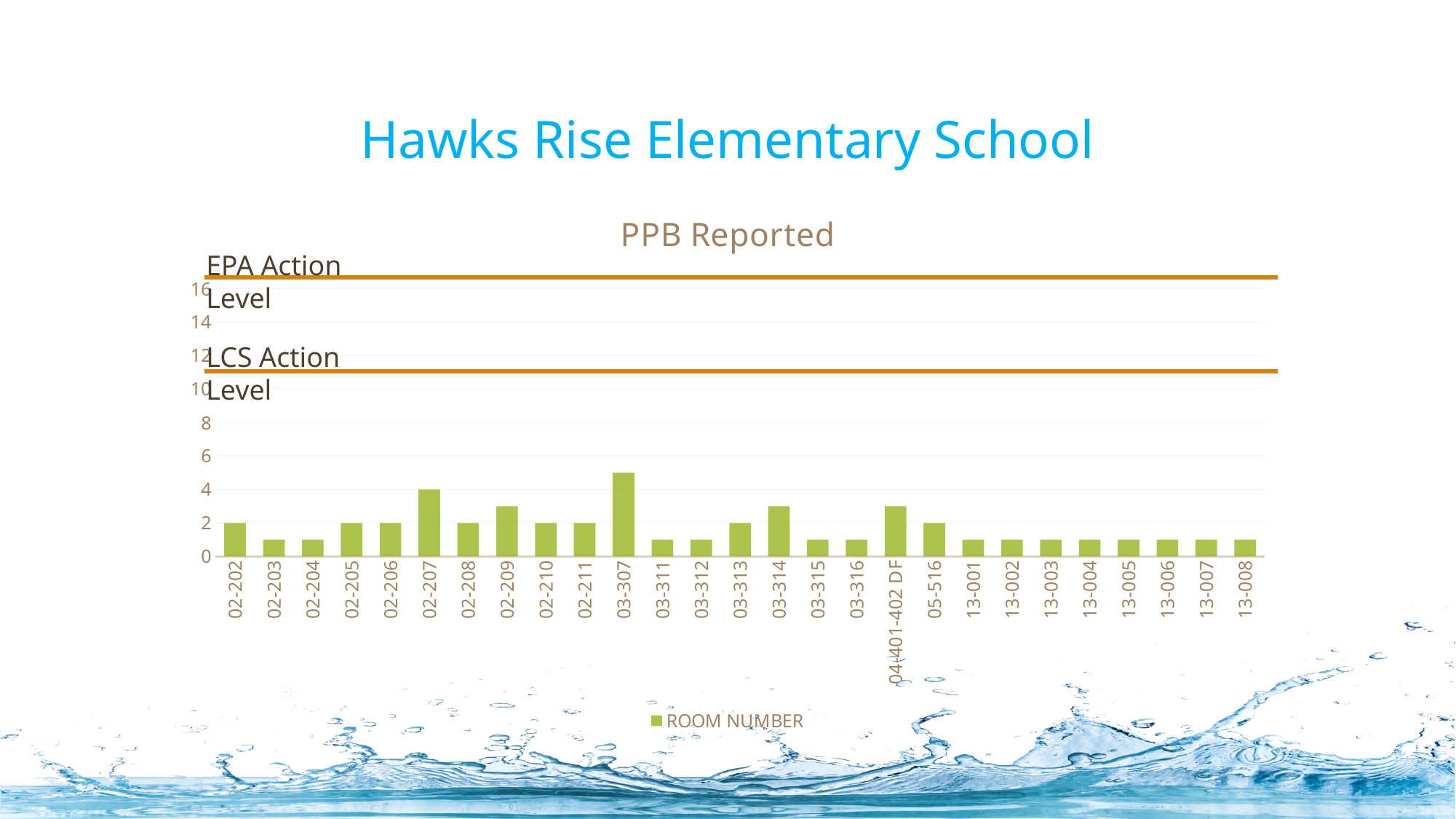
What is the legend entry for the plotted series? ROOM NUMBER How many series does the legend list? 1 Which room has the highest PPB reported value? 03-307 Is the value for room 03-307 greater or less than 4? greater What is the PPB reported value for room 02-207? 4 Is the value for room 02-203 greater or less than 2? less What is the PPB reported value for room 02-202? 2 What type of chart is shown on the slide? bar chart What is the difference between the values for room 02-207 and room 02-202? 2 How many room categories are plotted on the x axis? 27 Which has a larger value, room 02-207 or room 02-209? 02-207 What is the title of the chart? PPB Reported